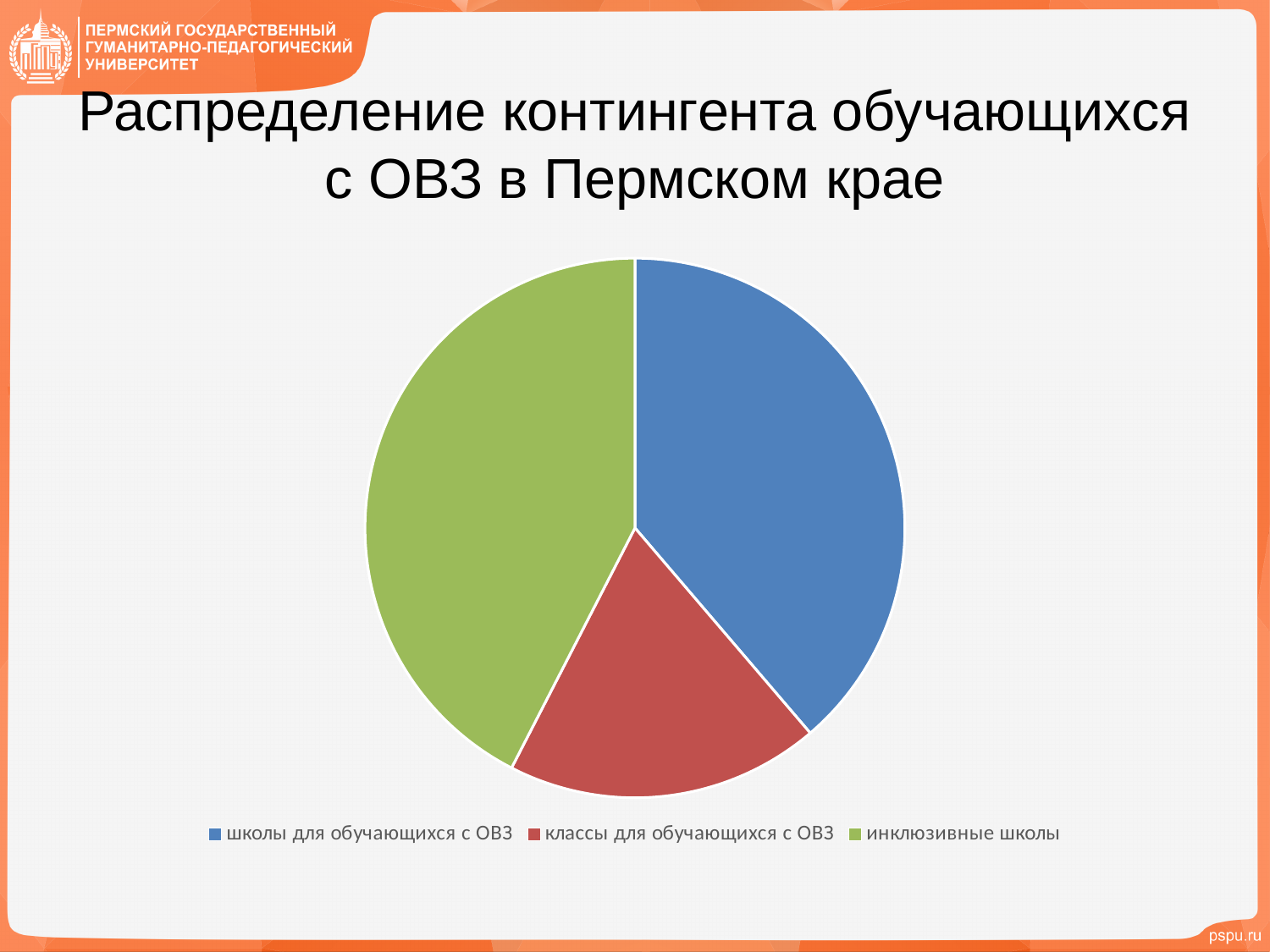
Which slice is larger: инклюзивные школы or классы для обучающихся с ОВЗ? инклюзивные школы What is the title of the slide containing the pie chart? Распределение контингента обучающихся с ОВЗ в Пермском крае What colour is the slice for инклюзивные школы in the pie chart? green Which slice is larger: школы для обучающихся с ОВЗ or классы для обучающихся с ОВЗ? школы для обучающихся с ОВЗ How many entries does the legend of the pie chart list? 3 Which category has the smallest slice of the pie chart? классы для обучающихся с ОВЗ Which category has the largest slice of the pie chart? инклюзивные школы What kind of chart is shown on the slide? pie chart How many slices does the pie chart have? 3